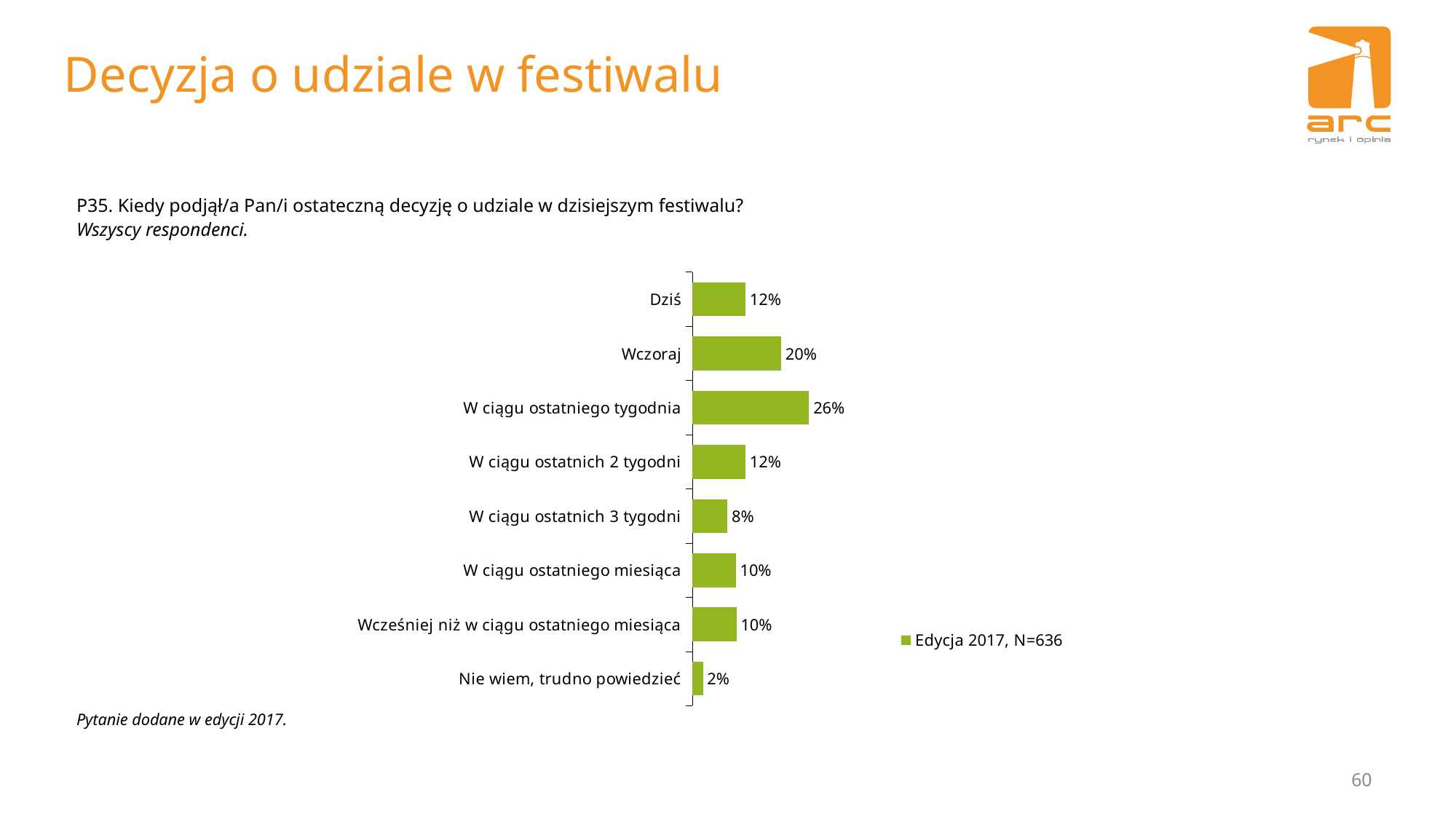
Which is larger: the value for "Wczoraj" or the value for "W ciągu ostatniego miesiąca"? Wczoraj What is the value for "W ciągu ostatniego tygodnia"? 26% What is the value for "Wczoraj"? 20% What is the difference between the values for "Dziś" and "W ciągu ostatnich 3 tygodni"? 4% What is the value for "W ciągu ostatnich 3 tygodni"? 8% Which category has the highest value? W ciągu ostatniego tygodnia What kind of chart is shown on the slide? Bar chart What is the difference between the values for "W ciągu ostatniego tygodnia" and "Wczoraj"? 6% How many categories are shown in the chart? 8 Which category has the lowest value? Nie wiem, trudno powiedzieć What is the value for "Nie wiem, trudno powiedzieć"? 2% How many series does the legend list? 1